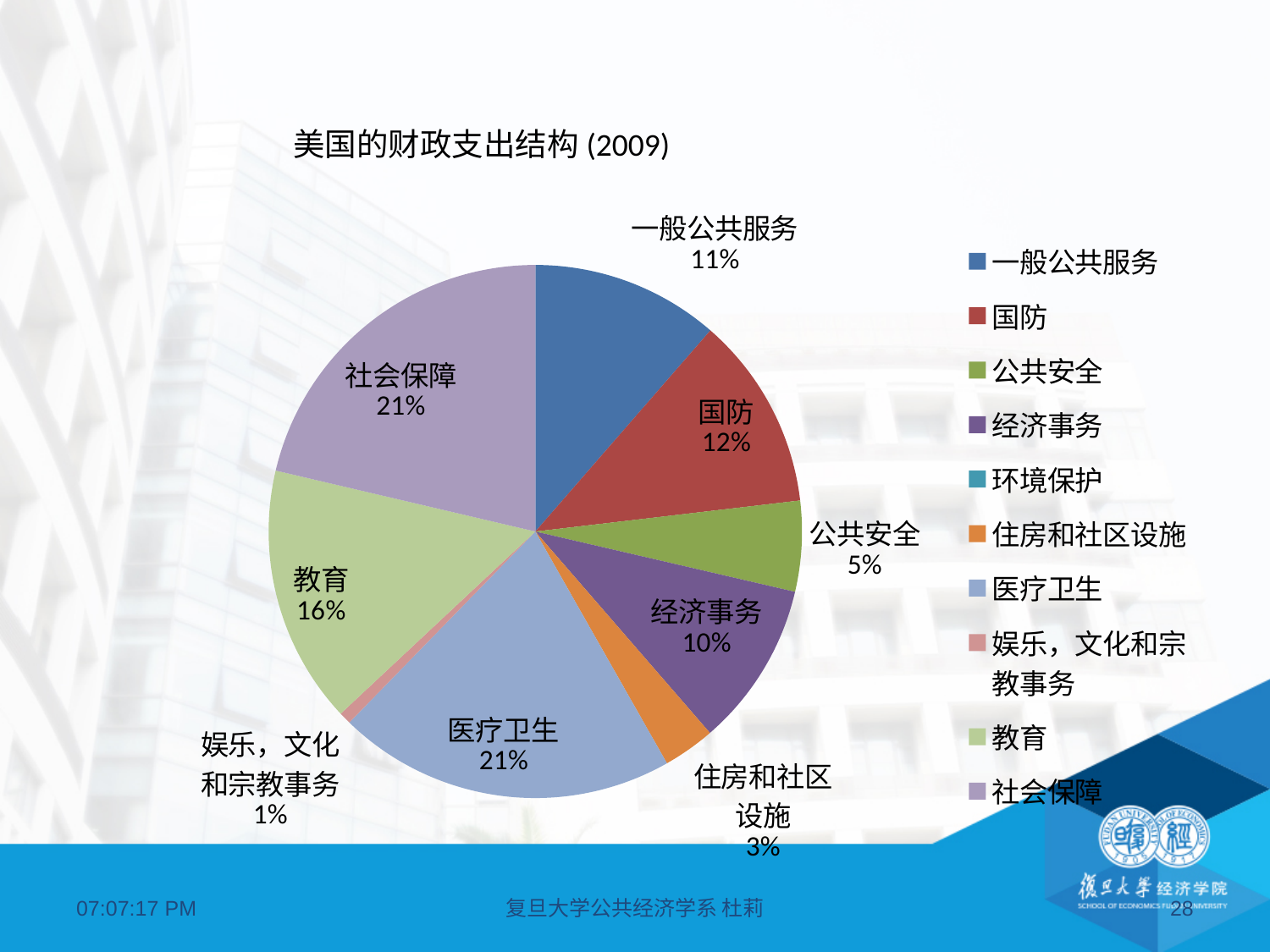
Which has the larger share, 公共安全 or 住房和社区设施? 公共安全 What is the value shown for 医疗卫生? 21% What percentage is labeled for 住房和社区设施? 3% What is the title of the chart? 美国的财政支出结构 (2009) What share does 教育 have in the pie chart? 16% How many categories are listed in the chart's legend? 10 Which is larger, 国防 or 一般公共服务? 国防 What is the value shown for 娱乐，文化和宗教事务? 1% What is the difference between the shares of 医疗卫生 and 经济事务? 11% What percentage of the pie chart is 国防? 12% How many percentage points larger is 社会保障 than 教育? 5% What type of chart is shown on the slide? pie chart